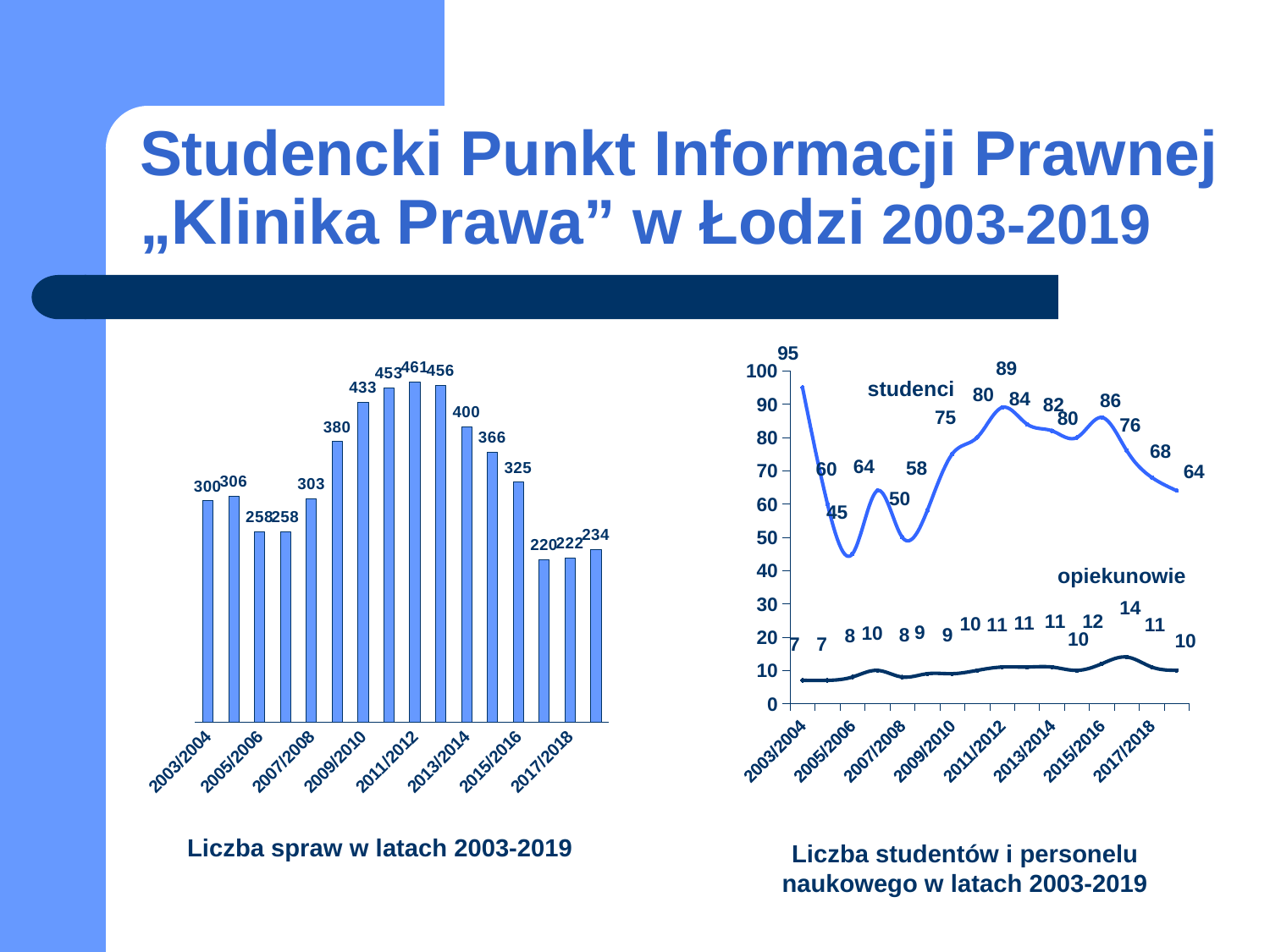
In the left chart 'Liczba spraw w latach 2003-2019', what is the difference between the values for 2009/2010 and 2005/2006? 175 How many series are plotted in the right chart 'Liczba studentów i personelu naukowego w latach 2003-2019'? 2 What kind of chart is the left chart, 'Liczba spraw w latach 2003-2019'? bar chart In the right chart 'Liczba studentów i personelu naukowego w latach 2003-2019', what is the value of the opiekunowie series for 2011/2012? 11 In the left chart 'Liczba spraw w latach 2003-2019', what is the lowest value shown? 220 In the left chart 'Liczba spraw w latach 2003-2019', what is the value for 2011/2012? 461 In the right chart 'Liczba studentów i personelu naukowego w latach 2003-2019', which series has the higher value for 2015/2016, studenci or opiekunowie? studenci How many bars are in the left chart 'Liczba spraw w latach 2003-2019'? 16 In the right chart 'Liczba studentów i personelu naukowego w latach 2003-2019', what is the lowest value of the studenci series? 45 In the left chart 'Liczba spraw w latach 2003-2019', what is the highest value shown? 461 In the left chart 'Liczba spraw w latach 2003-2019', what is the value for 2003/2004? 300 In the right chart 'Liczba studentów i personelu naukowego w latach 2003-2019', what is the value of the studenci series for 2003/2004? 95